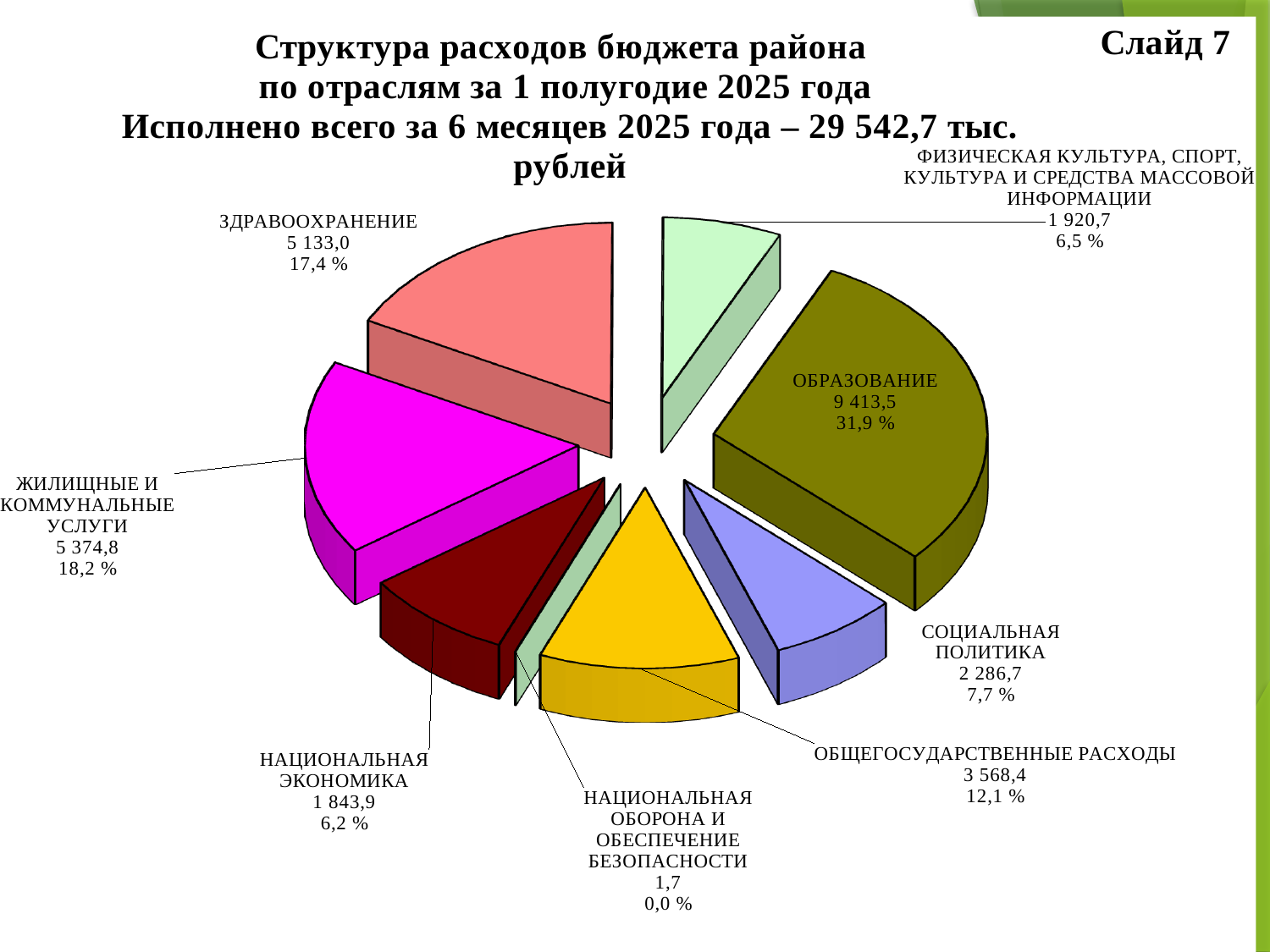
Which is larger: the value for ОБЩЕГОСУДАРСТВЕННЫЕ РАСХОДЫ or the value for СОЦИАЛЬНАЯ ПОЛИТИКА? ОБЩЕГОСУДАРСТВЕННЫЕ РАСХОДЫ According to the slide title, what is the total executed amount for 6 months of 2025? 29 542,7 тыс. рублей Which category has the smallest share of the pie? НАЦИОНАЛЬНАЯ ОБОРОНА И ОБЕСПЕЧЕНИЕ БЕЗОПАСНОСТИ How many slices (categories) does the pie chart have? 8 Which category has the largest share of the pie? ОБРАЗОВАНИЕ What type of chart is shown on the slide? pie chart What percentage share is shown for ФИЗИЧЕСКАЯ КУЛЬТУРА, СПОРТ, КУЛЬТУРА И СРЕДСТВА МАССОВОЙ ИНФОРМАЦИИ? 6,5 % What is the value shown for ОБРАЗОВАНИЕ? 9 413,5 What is the value shown for СОЦИАЛЬНАЯ ПОЛИТИКА? 2 286,7 What is the difference in percentage points between the shares of ОБРАЗОВАНИЕ and ЖИЛИЩНЫЕ И КОММУНАЛЬНЫЕ УСЛУГИ? 13,7 What percentage share is shown for ЖИЛИЩНЫЕ И КОММУНАЛЬНЫЕ УСЛУГИ? 18,2 % What is the difference between the values for ЖИЛИЩНЫЕ И КОММУНАЛЬНЫЕ УСЛУГИ and ЗДРАВООХРАНЕНИЕ? 241,8